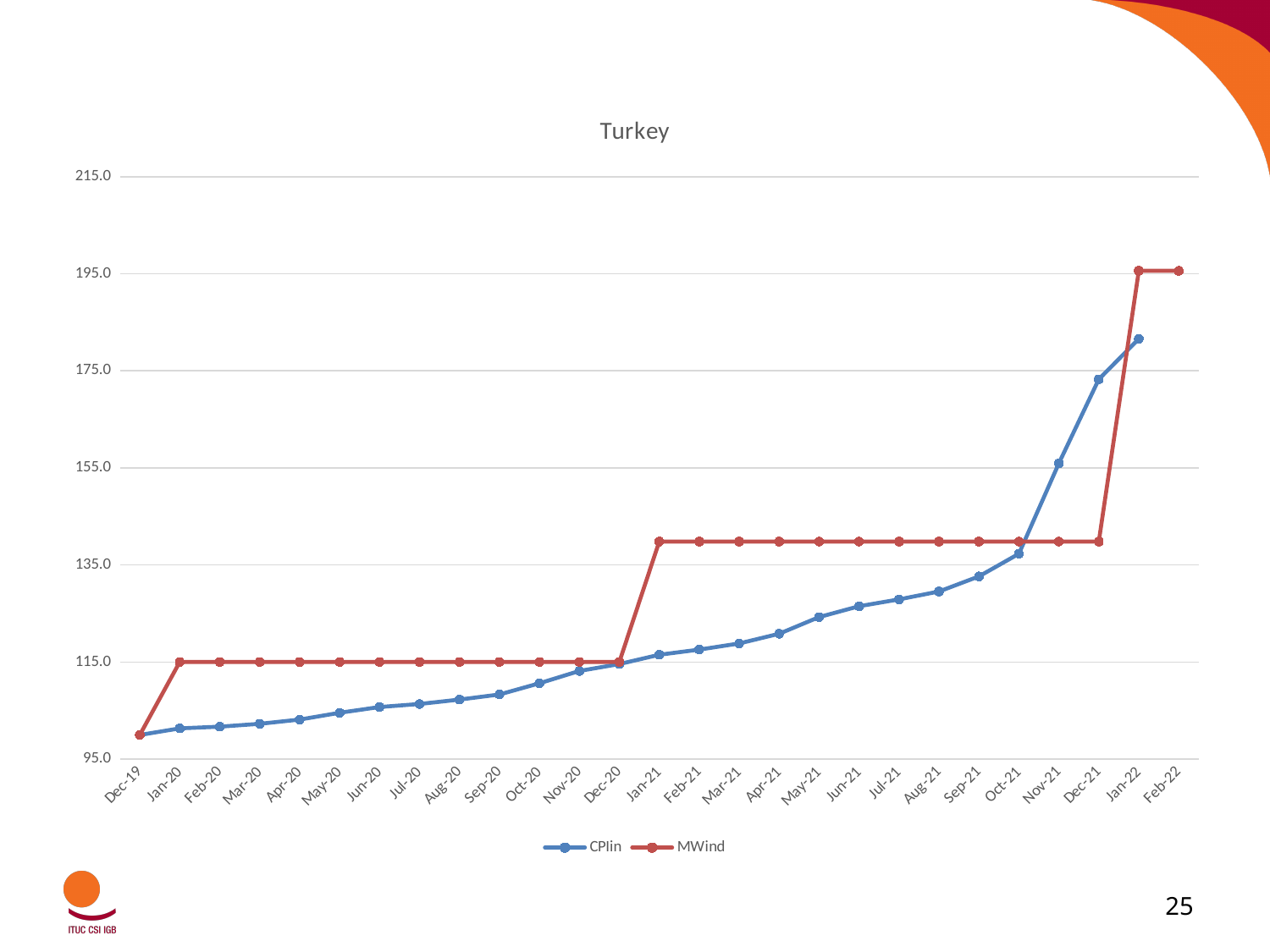
In which month does the CPIin series reach its highest value? Jan-22 What are the names of the two series in the legend? CPIin and MWind Is the value for MWind at Feb-22 greater or less than 175.0? greater Which series has the higher value at Jan-22, CPIin or MWind? MWind Is the value for CPIin at Dec-21 greater or less than 155.0? greater Does the CPIin series rise or fall from Dec-19 to Jan-22? rise What is the title of the chart? Turkey Is the value for CPIin at Dec-19 greater or less than 115.0? less How many months are shown along the x axis? 27 Which series has the higher value at Nov-21, CPIin or MWind? CPIin How many series does the legend list? 2 What kind of chart is shown on the slide? line chart